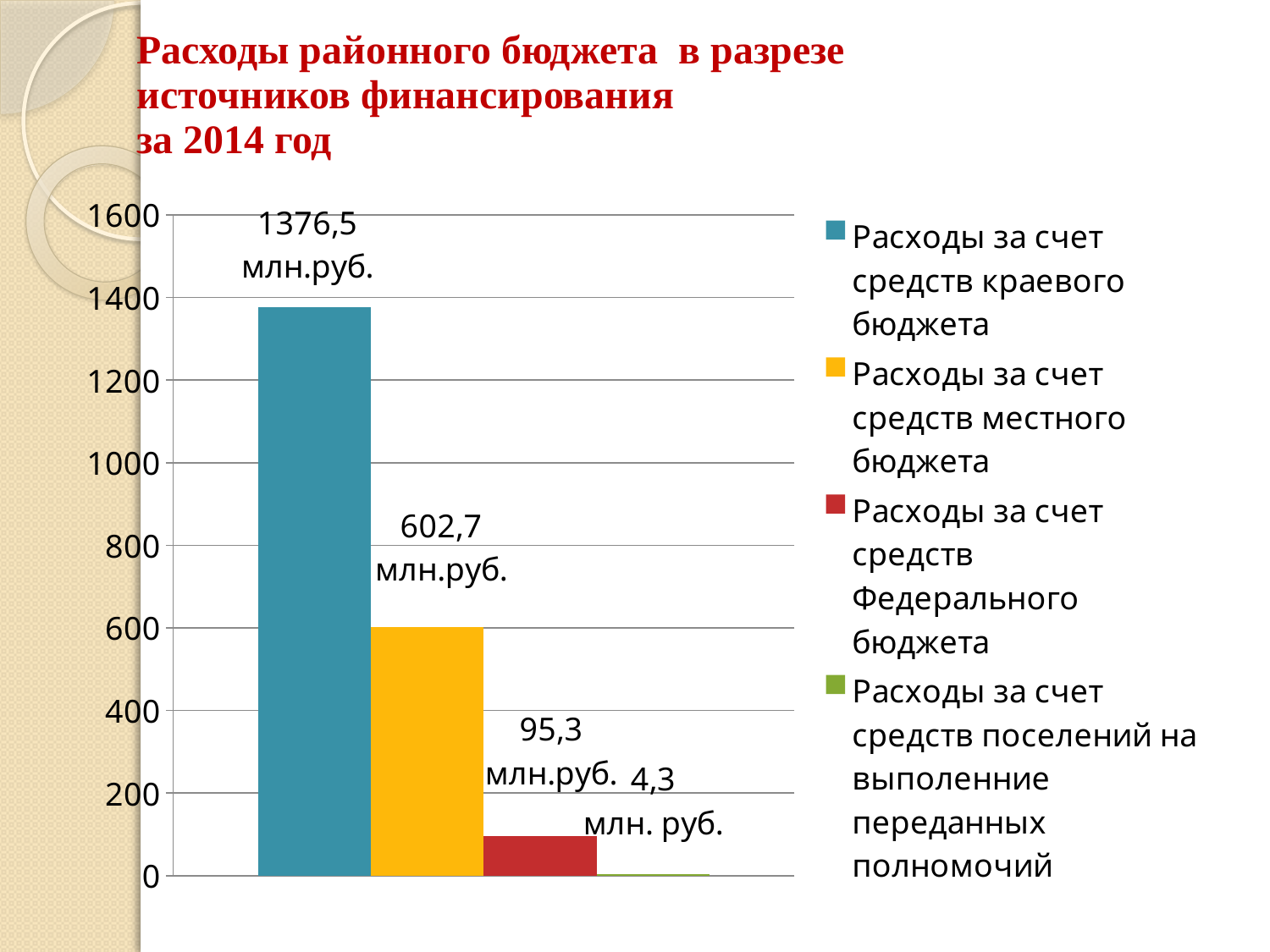
What colour is the bar for expenses funded by the local budget? Yellow What is the value for expenses funded by settlements' funds for transferred powers? 4,3 млн. руб. Which funding source has the highest expenses? Расходы за счет средств краевого бюджета How many series does the legend list? 4 Which funding source has the lowest expenses? Расходы за счет средств поселений на выполенние переданных полномочий What is the difference between expenses from the local budget and expenses from the Federal budget, in млн.руб.? 507,4 What is the value for expenses funded by the Federal budget? 95,3 млн.руб. What is the value for expenses funded by the local (местный) budget? 602,7 млн.руб. What is the difference between expenses from the regional budget and expenses from the local budget, in млн.руб.? 773,8 Which is larger: expenses from the Federal budget or expenses from settlements' funds? Expenses from the Federal budget What kind of chart is shown on the slide? Bar chart What is the value for expenses funded by the regional (краевой) budget? 1376,5 млн.руб.